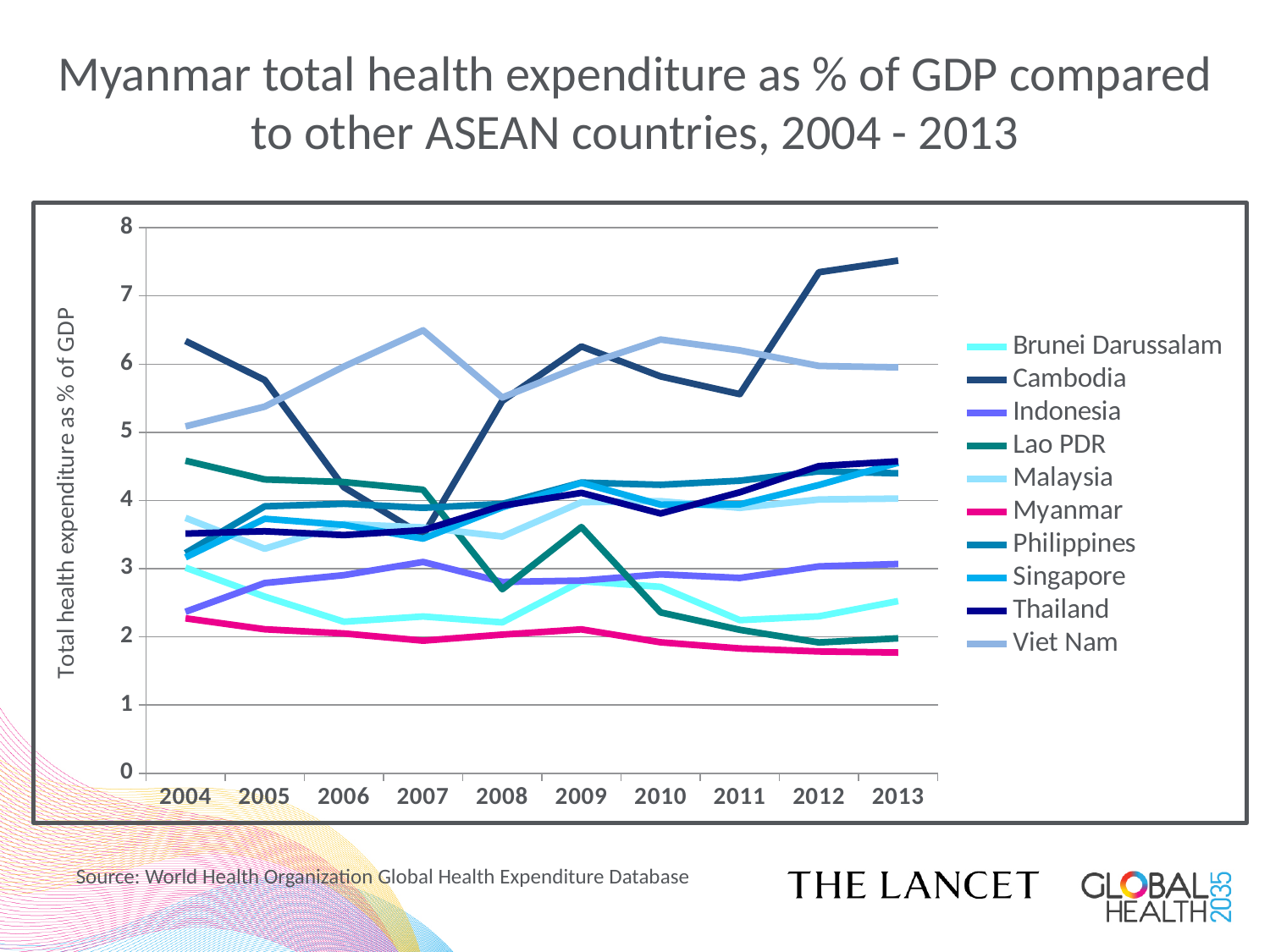
Is the value for Cambodia in 2012 greater or less than 7? greater Does Myanmar's total health expenditure as % of GDP rise or fall from 2004 to 2013? fall Which country has the highest total health expenditure as % of GDP in 2013? Cambodia Is the value for Myanmar in 2013 greater or less than 2? less Is the value for Viet Nam in 2007 greater or less than 6? greater How many countries does the legend list? 10 How many years are shown along the x axis? 10 What kind of chart is shown on the slide? line chart In 2010, which country has the higher value: Viet Nam or Indonesia? Viet Nam What is the label on the y axis? Total health expenditure as % of GDP What source is cited for the chart data? World Health Organization Global Health Expenditure Database Which country has the lowest total health expenditure as % of GDP in 2013? Myanmar